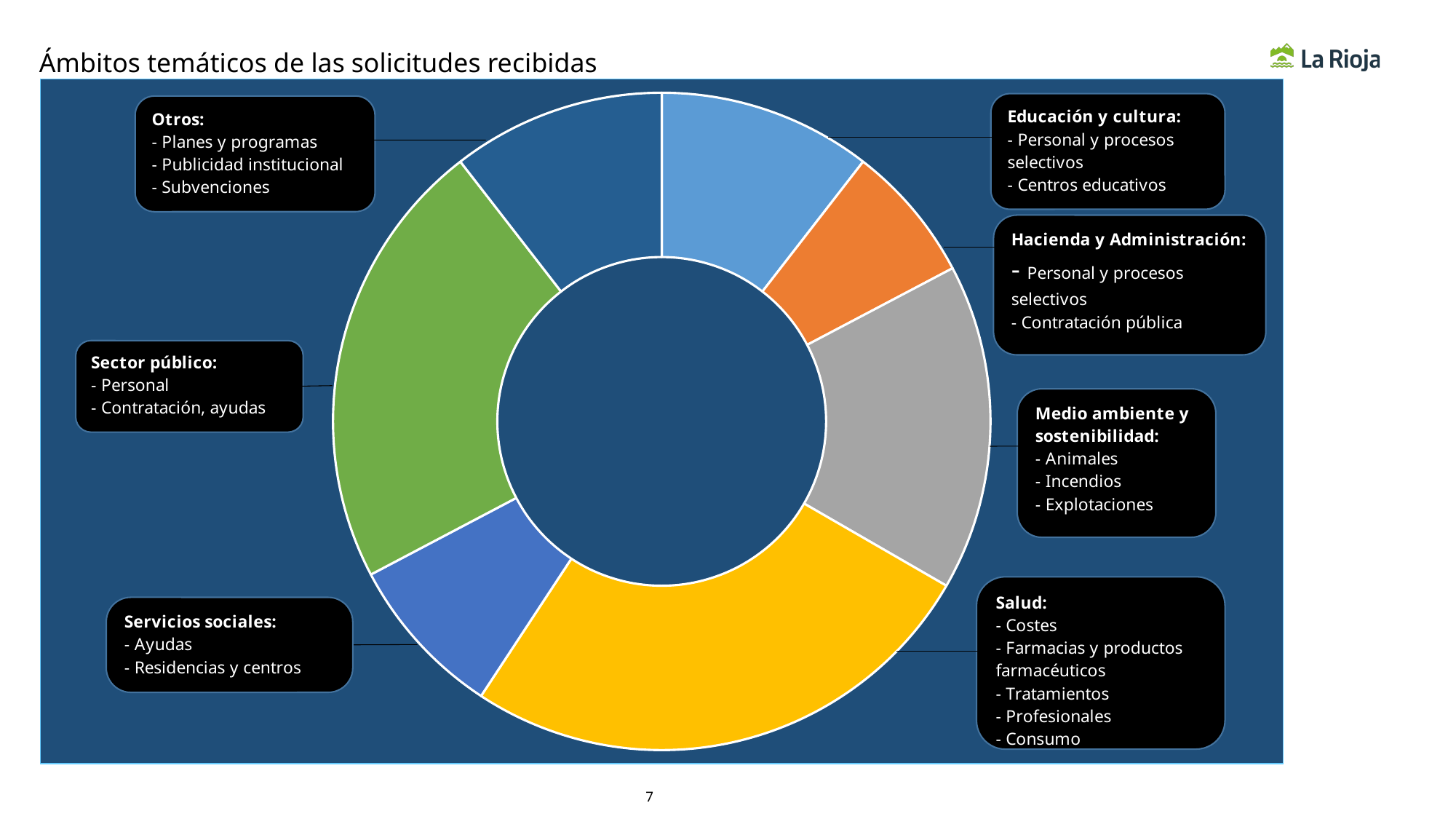
Which segment is larger, Sector público or Servicios sociales? Sector público What colour is the Salud segment of the chart? Yellow Which category has the largest segment in the chart? Salud What is the title of the slide containing the chart? Ámbitos temáticos de las solicitudes recibidas How many thematic categories (segments) does the chart show? 7 Which segment is larger, Salud or Educación y cultura? Salud Which segment is larger, Sector público or Medio ambiente y sostenibilidad? Sector público What kind of chart is shown on the slide? Pie chart (donut)